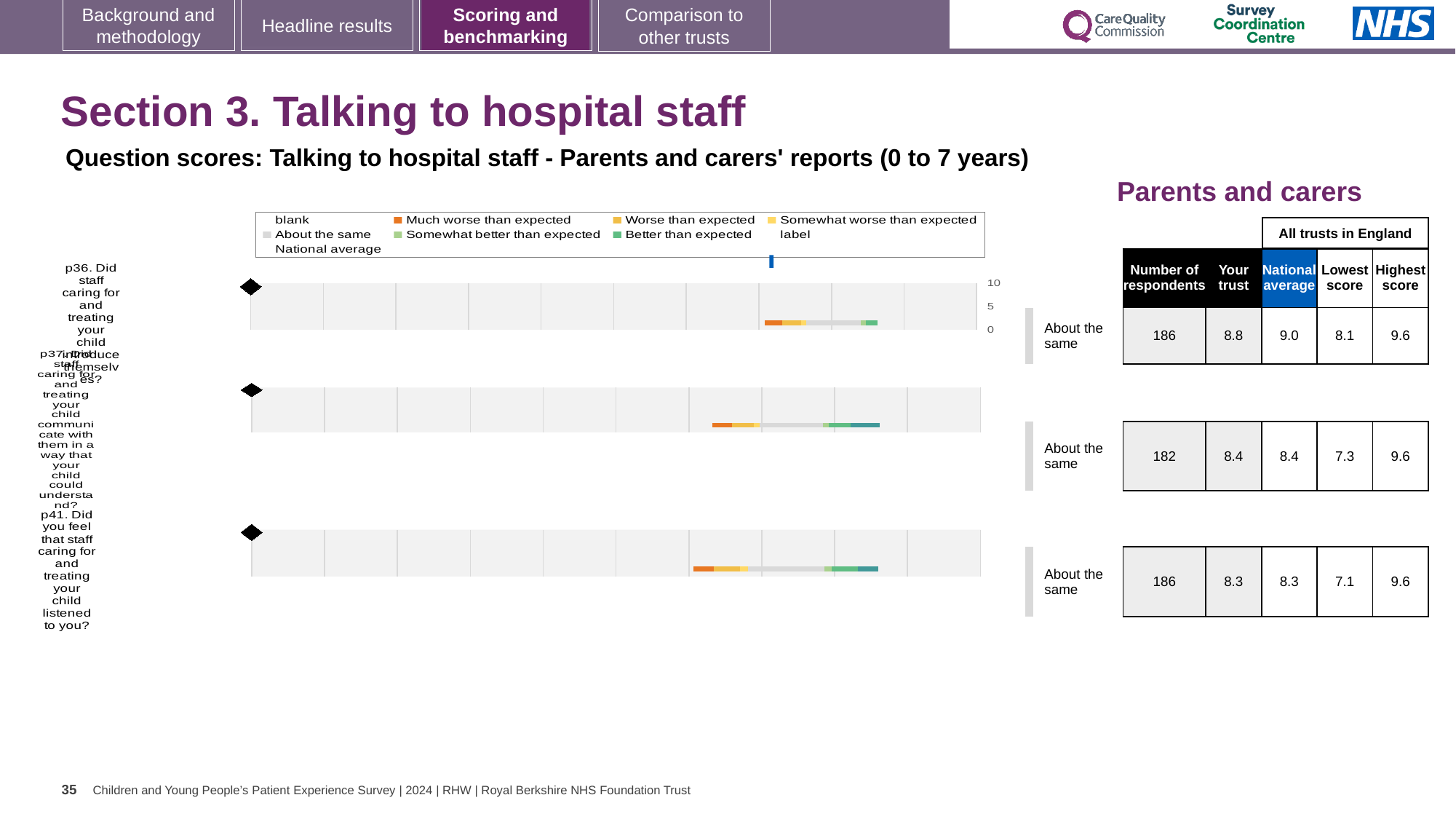
Which of the three questions (p36, p37, p41) has the highest 'Your trust' score? p36 For the p36 chart, what is the difference between the national average and the 'Your trust' score? 0.2 Is the 'Your trust' score higher for p36 or for p41? p36 For the p37 chart, how many respondents are there? 182 For the p41 chart (Did you feel that staff listened to you?), what is the lowest score among all trusts in England? 7.1 How many question charts (p36, p37, p41) are shown on the slide? 3 What kind of chart is used to show the question scores on this slide? bar chart For the p36 chart (Did staff caring for and treating your child introduce themselves?), what is the 'Your trust' score? 8.8 What is the maximum value shown on the score axis of the charts? 10 What benchmark category is shown next to the p36 chart? About the same Which of the three questions (p36, p37, p41) has the lowest 'Your trust' score? p41 For the p37 chart (Did staff communicate with your child in a way they could understand?), what is the national average score? 8.4